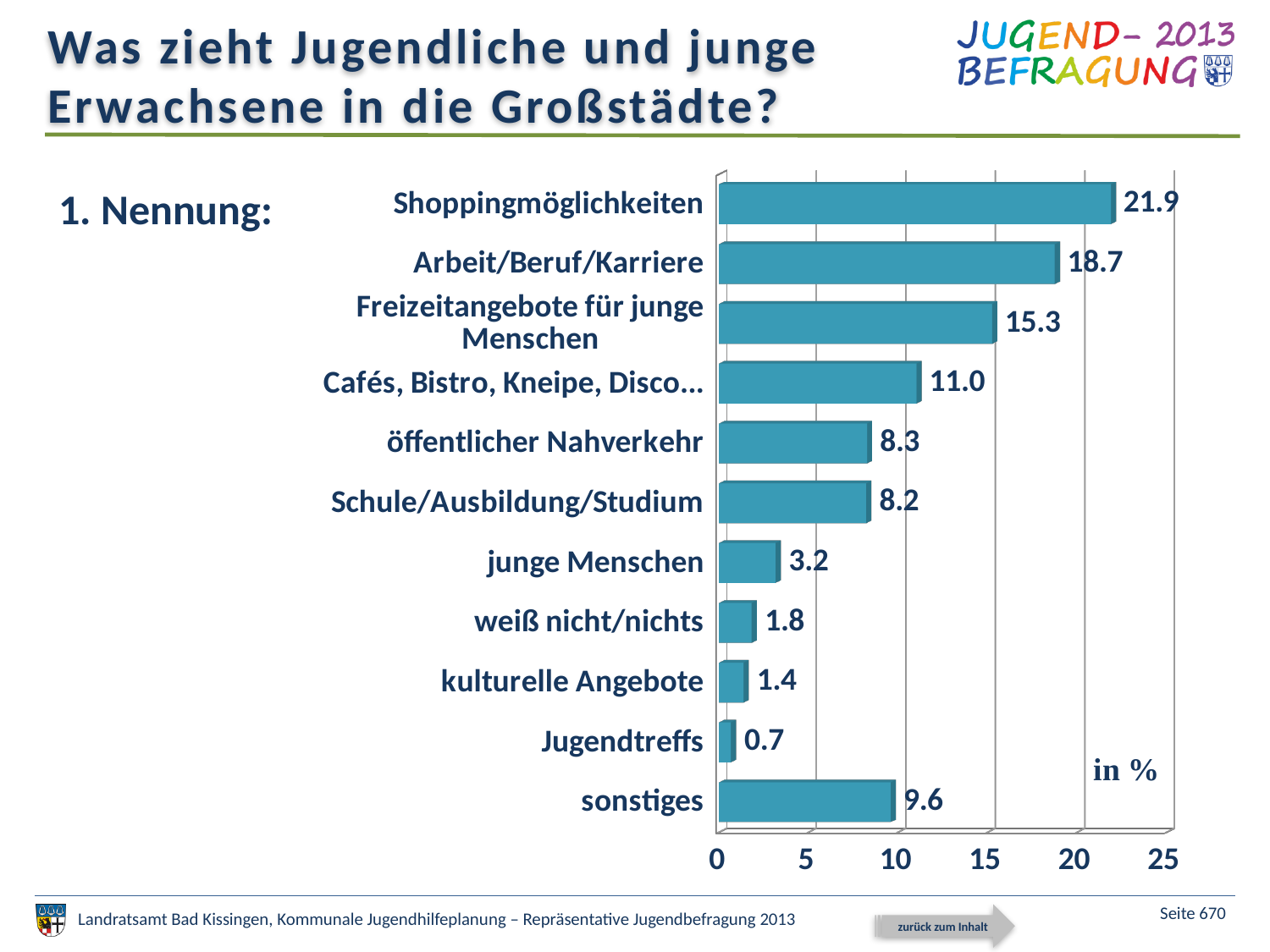
Which category has the highest value? Shoppingmöglichkeiten Which category has the lowest value? Jugendtreffs Is the value for Freizeitangebote für junge Menschen greater or less than 15? greater What is the value for sonstiges? 9.6 What is the value for öffentlicher Nahverkehr? 8.3 Which is larger, the value for Cafés, Bistro, Kneipe, Disco... or the value for sonstiges? Cafés, Bistro, Kneipe, Disco... What unit are the values given in, according to the label on the chart? in % What kind of chart is shown on the slide? bar chart How many categories are shown in the chart? 11 What is the difference between the values for junge Menschen and kulturelle Angebote? 1.8 What is the difference between the values for Shoppingmöglichkeiten and Arbeit/Beruf/Karriere? 3.2 What is the value for Shoppingmöglichkeiten? 21.9